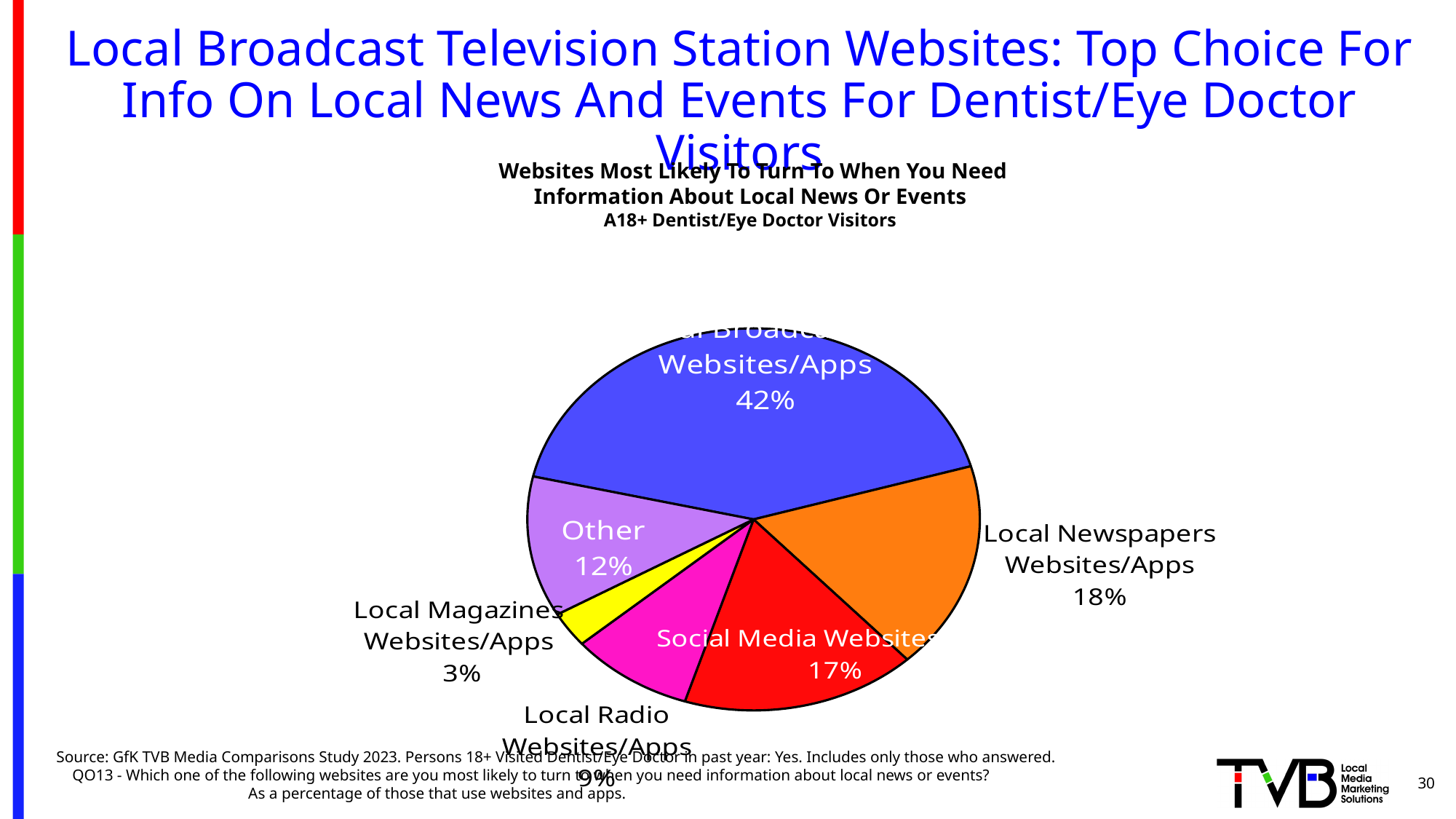
Which is larger: Other or Local Radio Websites/Apps? Other Which category has the largest slice of the pie? Local Broadcast TV Websites/Apps What percentage of A18+ Dentist/Eye Doctor Visitors chose Local Newspapers Websites/Apps? 18% What share of the pie is Social Media Websites? 17% What percentage is shown for Local Magazines Websites/Apps? 3% What share of the pie is labeled Other? 12% What percentage is shown for the largest slice, Local Broadcast TV Websites/Apps? 42% How many slices does the pie chart have? 6 What type of chart is shown on the slide? pie chart Which category has the smallest slice of the pie? Local Magazines Websites/Apps What percentage is shown for Local Radio Websites/Apps? 9% What is the difference in percentage points between Local Newspapers Websites/Apps and Local Radio Websites/Apps? 9